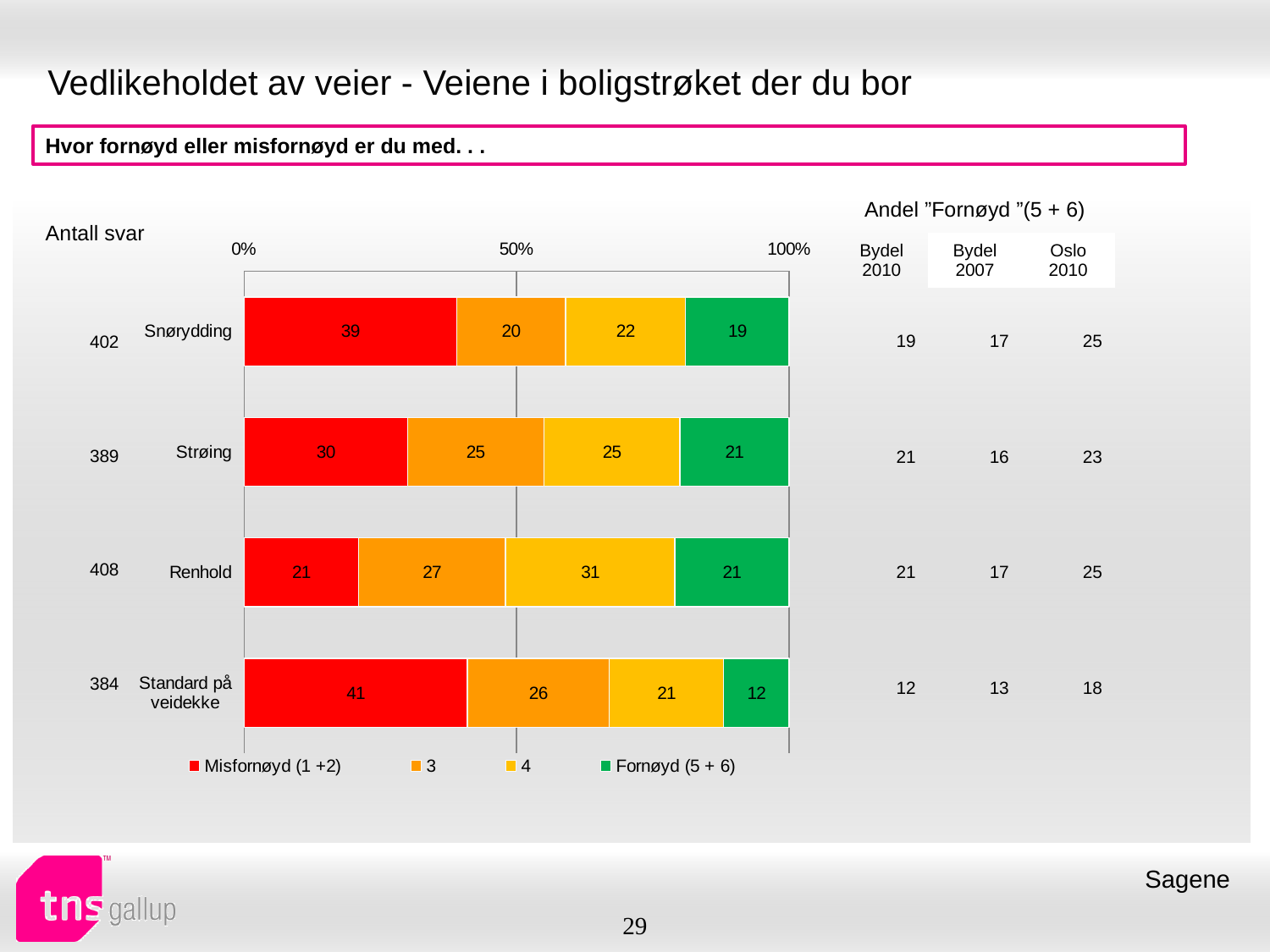
What kind of chart is shown on the slide? stacked bar chart Which is larger: the '4' segment for Renhold or the '4' segment for Snørydding? Renhold Which category has the highest Misfornøyd (1 +2) value? Standard på veidekke How many series does the chart legend list? 4 What is the difference between the Misfornøyd (1 +2) values for Snørydding and Renhold? 18 Which legend entry is shown in green? Fornøyd (5 + 6) Which category has the lowest Fornøyd (5 + 6) value? Standard på veidekke What is the value of the '4' segment for Renhold? 31 What is the value of the Fornøyd (5 + 6) segment for Strøing? 21 What is the value of the Misfornøyd (1 +2) segment for Snørydding? 39 How many categories are plotted in the chart? 4 What is the value of the '3' segment for Standard på veidekke? 26